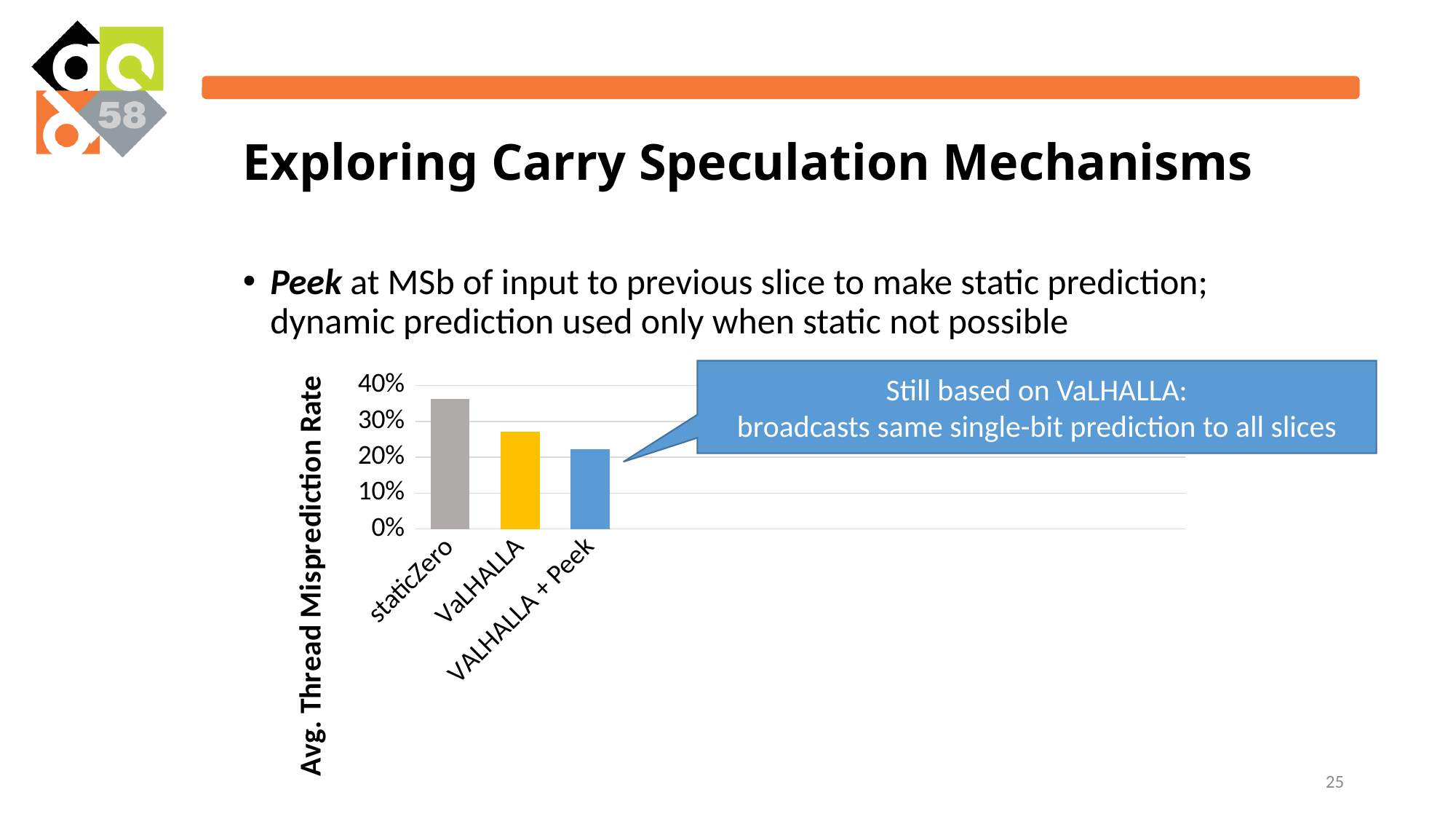
What kind of chart is shown on the slide? bar chart Which has a lower misprediction rate, VaLHALLA or VALHALLA + Peek? VALHALLA + Peek Which category has the lowest average thread misprediction rate? VALHALLA + Peek Do the bar values rise or fall from left to right across the categories? fall Which has a higher misprediction rate, staticZero or VaLHALLA? staticZero Is the value for VALHALLA + Peek greater or less than 20%? greater What colour is the bar for VaLHALLA? yellow What is the label of the vertical axis of the chart? Avg. Thread Misprediction Rate Which category has the highest average thread misprediction rate? staticZero How many categories are plotted in the chart? 3 Is the value for staticZero greater or less than 30%? greater Is the value for VaLHALLA greater or less than 30%? less